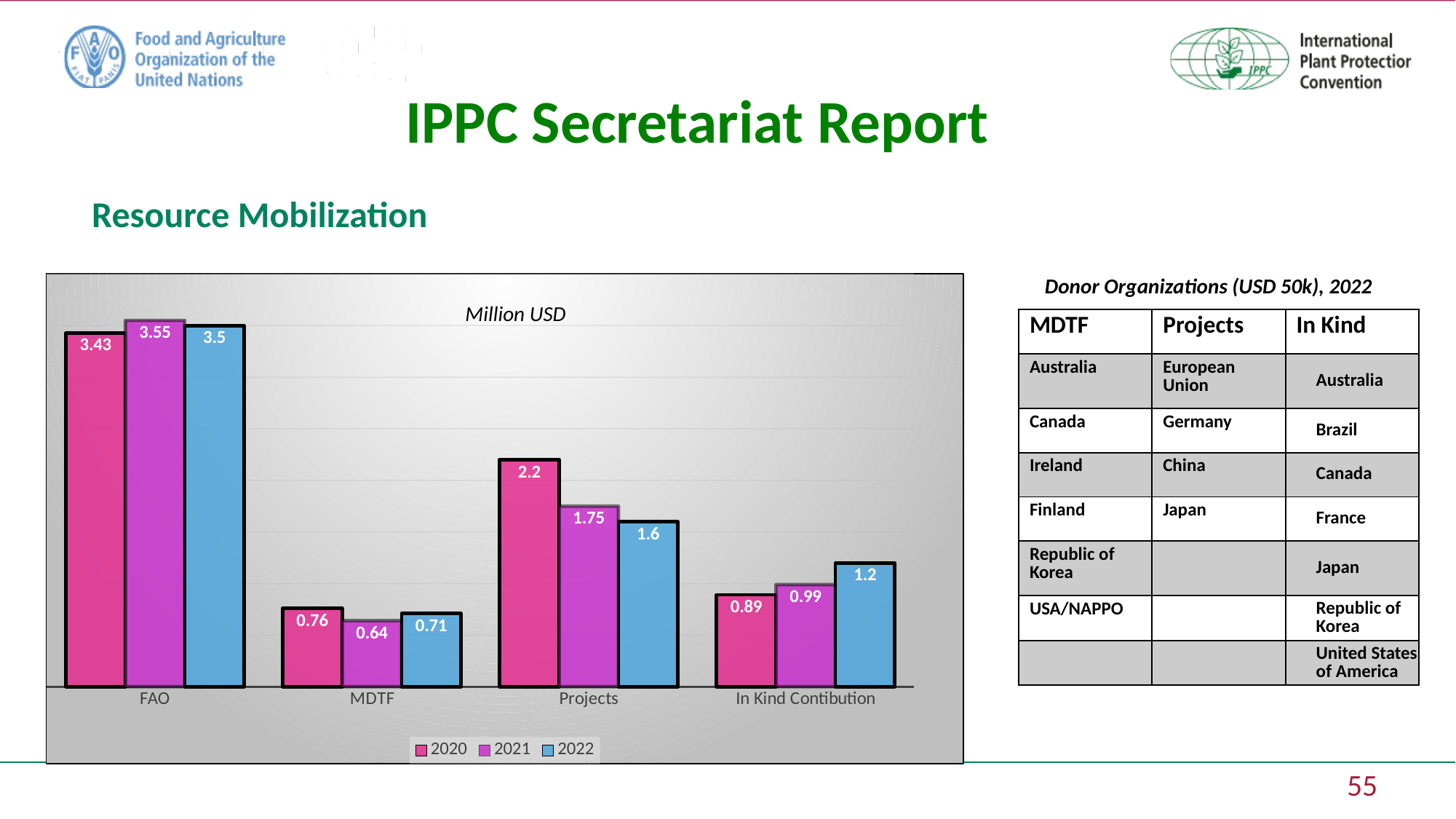
What is the value for FAO in 2021? 3.55 How many categories are shown on the x axis? 4 What is the value for MDTF in 2021? 0.64 How many series does the legend list? 3 Do the values for In Kind Contibution rise or fall from 2020 to 2022? Rise What is the value for In Kind Contibution in 2022? 1.2 What is the value for Projects in 2020? 2.2 Which is larger for MDTF: the 2020 value or the 2022 value? 2020 Which category has the highest value in 2022? FAO What kind of chart is shown on the slide? Bar chart Which category has the lowest value in 2020? MDTF What is the difference between the 2020 and 2022 values for Projects? 0.6